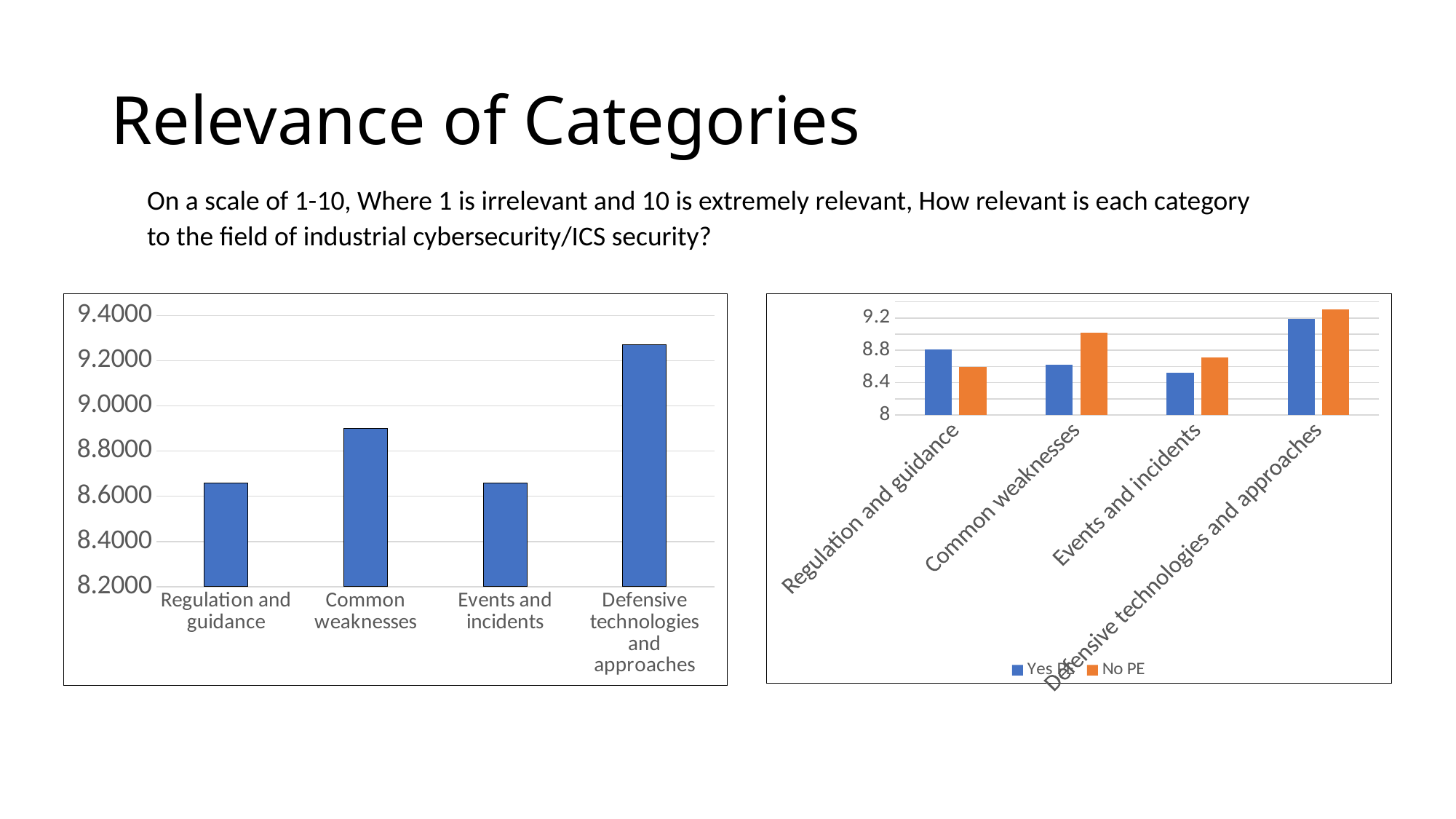
How many categories are shown on the x axis of the left chart? 4 In the right chart, for Regulation and guidance, which series has the larger value, Yes PE or No PE? Yes PE In the left chart, is the value for Defensive technologies and approaches greater or less than 9.2000? greater In the right chart, is the No PE value for Common weaknesses greater or less than 8.8? greater How many series does the legend of the right chart list? 2 What kind of chart is the left chart? bar chart In the left chart, is the value for Common weaknesses greater or less than 8.8000? greater What are the two series named in the legend of the right chart? Yes PE and No PE In the left chart, which category has the highest value? Defensive technologies and approaches In the right chart, for Common weaknesses, which series has the larger value, Yes PE or No PE? No PE In the right chart, which category has the highest Yes PE value? Defensive technologies and approaches